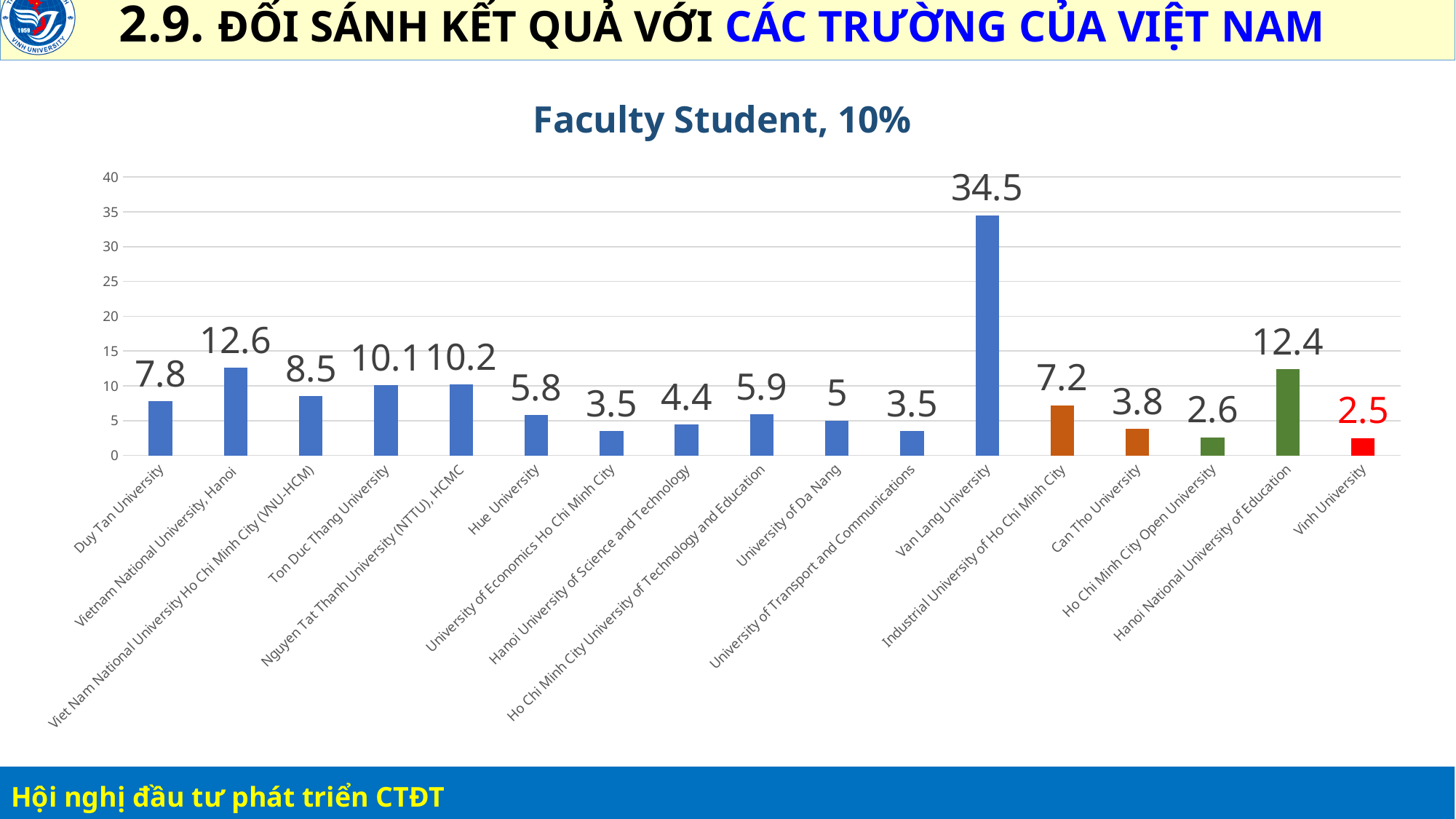
What is the value for Van Lang University? 34.5 What is the value for Vinh University? 2.5 How many universities are shown on the chart? 17 Which university has the highest value? Van Lang University Which university has the lowest value? Vinh University Which is larger, the value for Ton Duc Thang University or the value for Industrial University of Ho Chi Minh City? Ton Duc Thang University What is the title of the chart? Faculty Student, 10% What is the difference between the values for Van Lang University and Vinh University? 32 What is the value for Hue University? 5.8 What is the difference between the values for Vietnam National University, Hanoi and Duy Tan University? 4.8 What kind of chart is shown on the slide? Bar chart What is the value for Hanoi National University of Education? 12.4